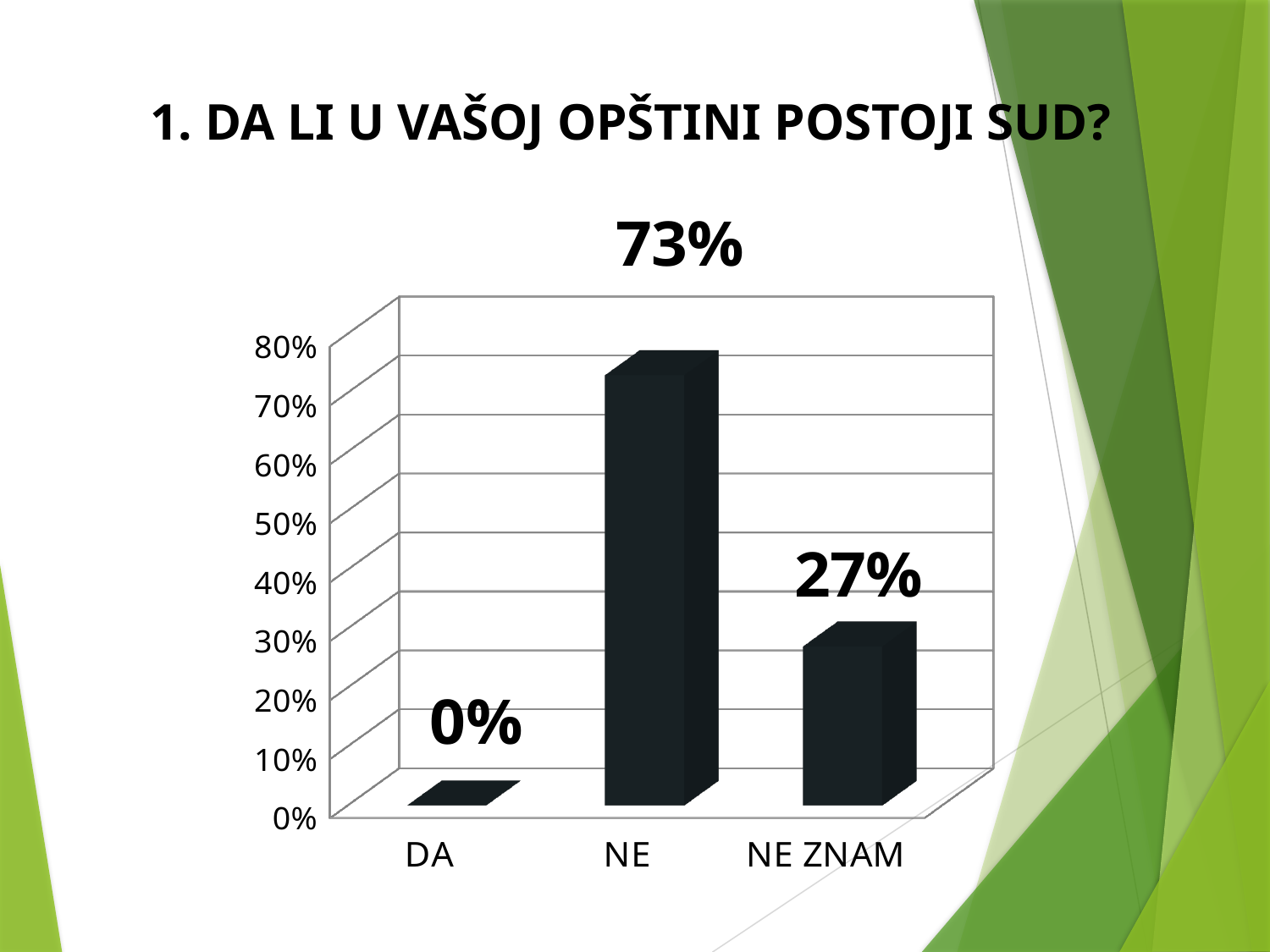
What is the value for DA? 0% Is the value for NE ZNAM greater or less than 40%? less What is the difference between the values for NE and NE ZNAM? 46% What is the value for NE? 73% Is the value for NE greater or less than 50%? greater What kind of chart is shown on the slide? bar chart Which category has the lowest value? DA What is the title of the slide above the chart? 1. DA LI U VAŠOJ OPŠTINI POSTOJI SUD? How many categories are shown on the x axis? 3 Which is larger, the value for NE or the value for NE ZNAM? NE Which category has the highest value? NE What is the value for NE ZNAM? 27%